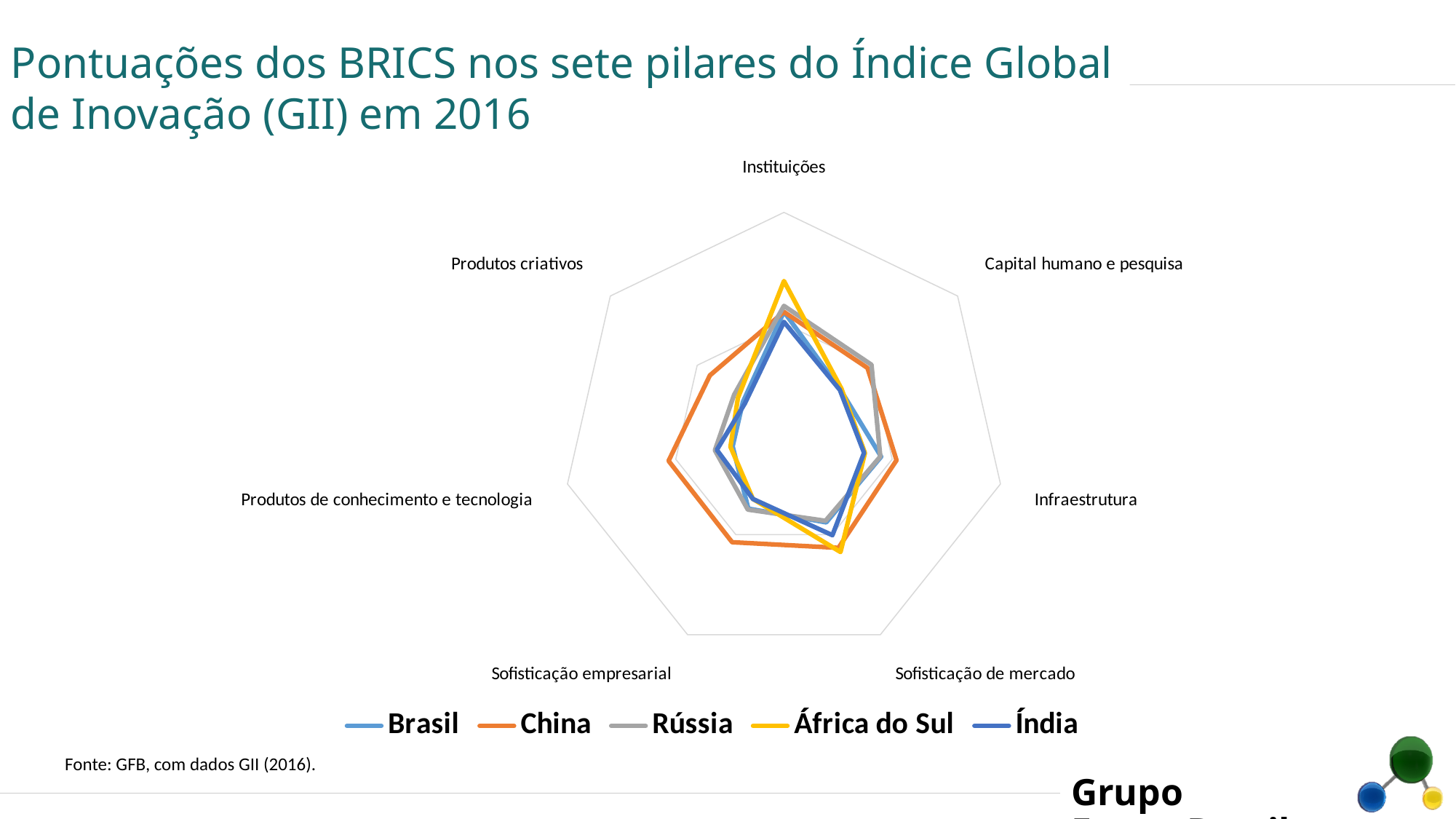
What is the title of the chart on the slide? Pontuações dos BRICS nos sete pilares do Índice Global de Inovação (GII) em 2016 Which country has the highest score on the Sofisticação empresarial axis? China Which country has the highest score on the Produtos criativos axis? China On the Sofisticação empresarial axis, which scores higher: China or Índia? China Which country has the lowest score on the Instituições axis? Índia Which country has the highest score on the Produtos de conhecimento e tecnologia axis? China How many pillars (categories) are plotted on the radar chart? 7 Which country is represented by the orange line in the legend? China On the Produtos criativos axis, which scores higher: China or Brasil? China How many series does the legend list? 5 What kind of chart is shown on the slide? Radar chart